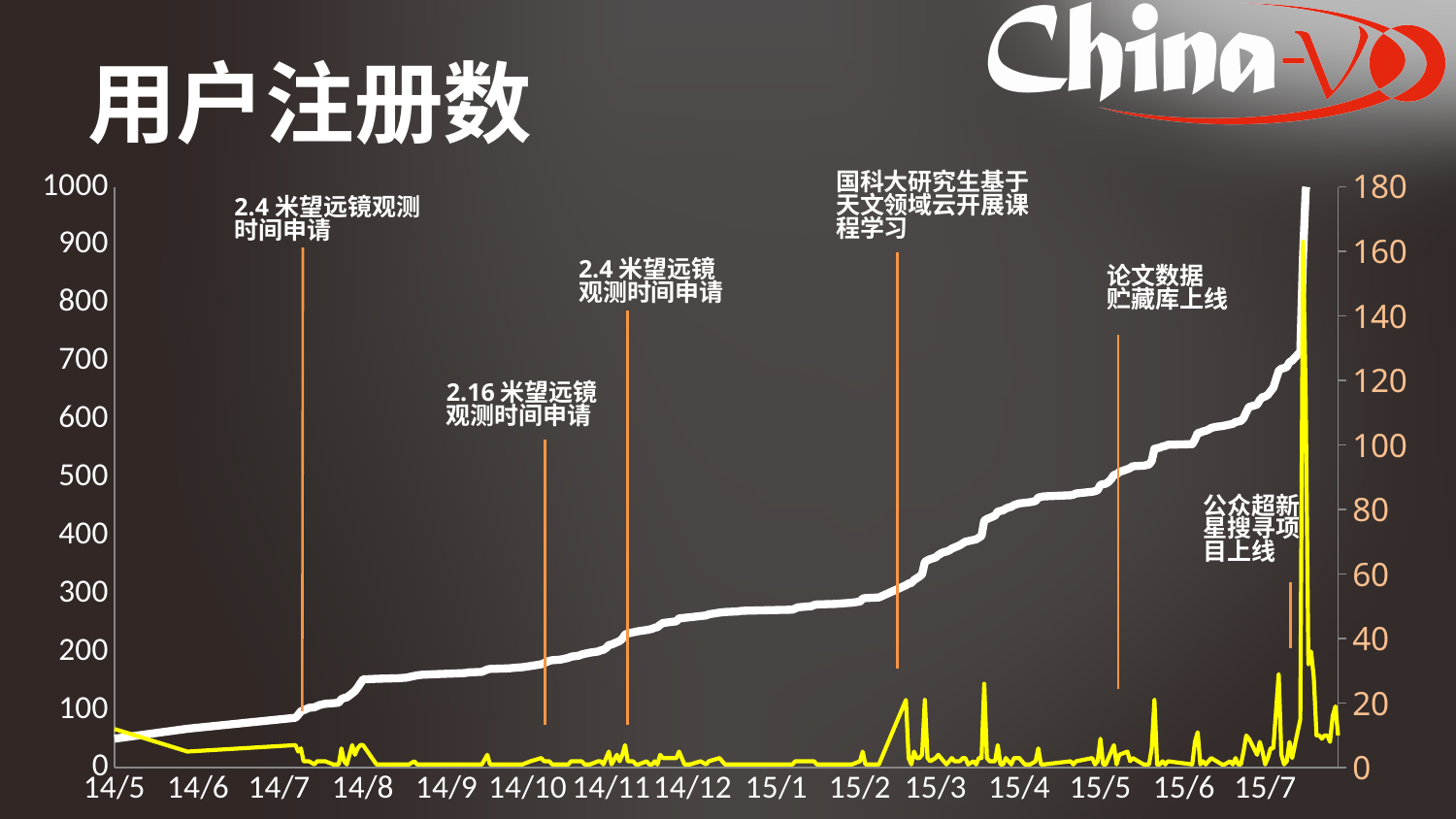
Does the white line rise or fall as it moves from 14/5 to 15/7 along the x axis? rise Is the value of the white line at 14/8 greater or less than 100 on the left axis? greater How many labels are shown on the x axis? 15 What is the highest value shown on the left y axis? 1000 What kind of chart is shown on the slide? line chart What is the highest value shown on the right y axis? 180 Is the value of the white line at 14/12 greater or less than 200 on the left axis? greater What is the title of the chart? 用户注册数 Is the value of the white line at 15/6 greater or less than 500 on the left axis? greater Which is larger, the white line's value at 15/6 or at 14/8? 15/6 Near which x-axis label does the yellow line reach its highest peak? 15/7